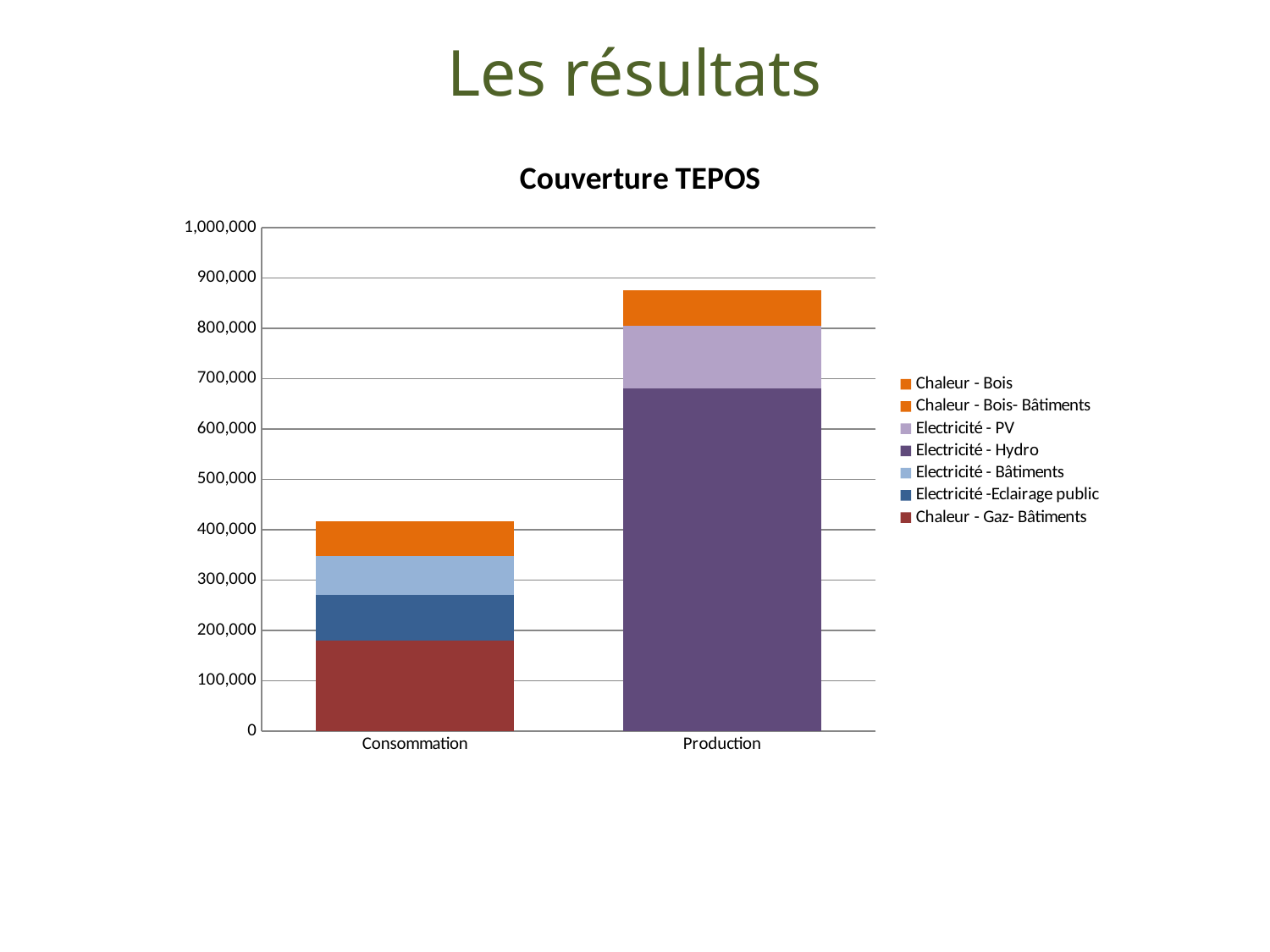
Is the Electricité - Hydro segment in the Production bar greater or less than 600,000? greater What is the title of the chart? Couverture TEPOS Is the total value for Consommation greater or less than 500,000? less Which bar is taller, Consommation or Production? Production How many series does the chart legend list? 7 Is the total value for Production greater or less than 800,000? greater Which series appears only in the Production bar and is shown in dark purple in the legend? Electricité - Hydro What kind of chart is shown on the slide? Stacked bar chart How many categories are shown on the x axis of the chart? 2 Which category has the highest total stacked value? Production Which category has the lowest total stacked value? Consommation